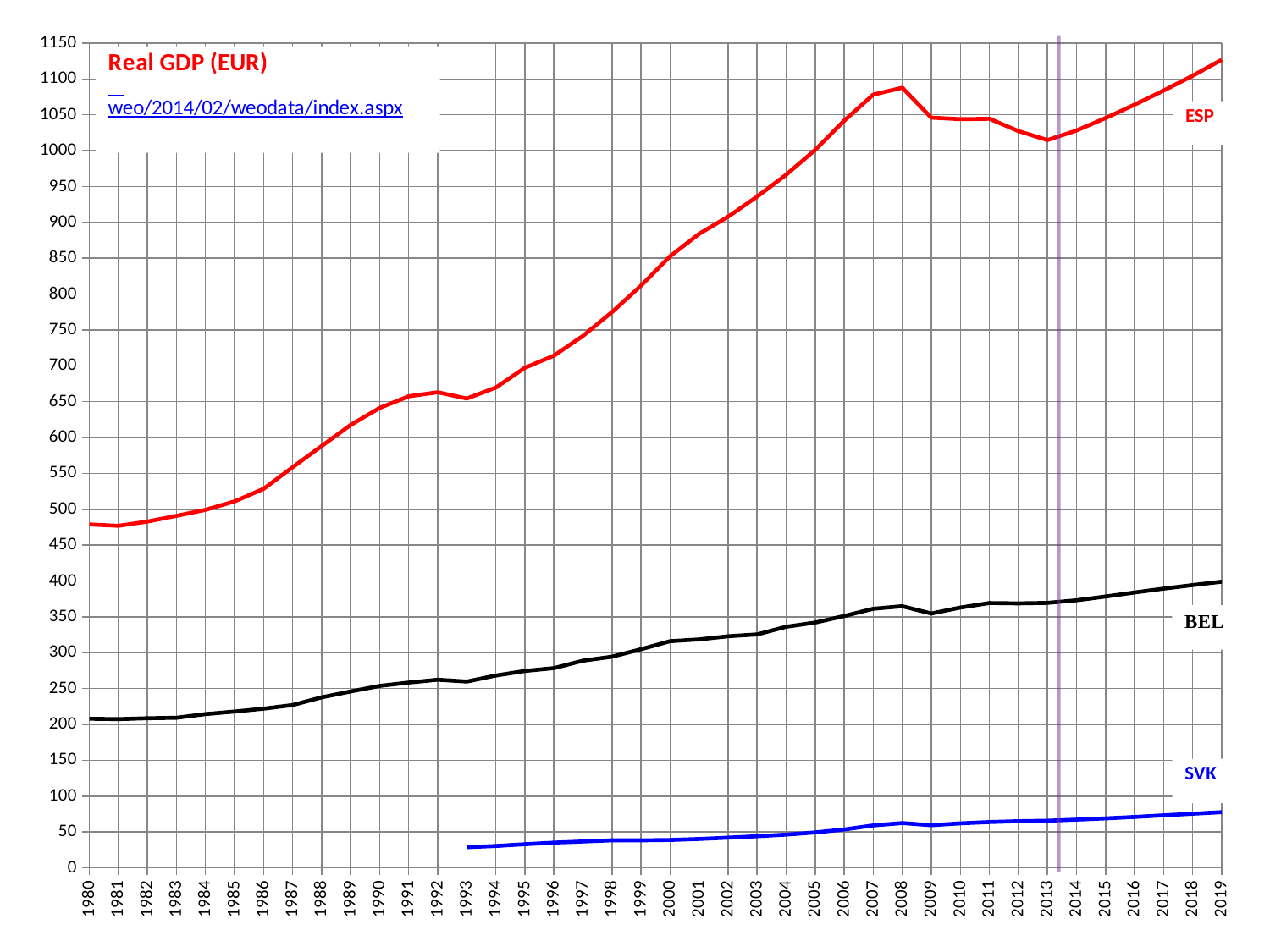
Is the value for ESP in 1980 greater or less than 500? less What kind of chart is shown on the slide? line chart Does the ESP line rise or fall between 2008 and 2013? fall What is the title of the chart? Real GDP (EUR) Which is larger, the value for BEL in 2019 or the value for SVK in 2019? BEL in 2019 Is the value for ESP in 2008 greater or less than 1050? greater Which series has the lowest values across the chart? SVK How many series (countries) are plotted on the chart? 3 Is the value for BEL in 2019 greater or less than 350? greater Which series has the highest values across the chart? ESP In which year does the SVK series first appear on the chart? 1993